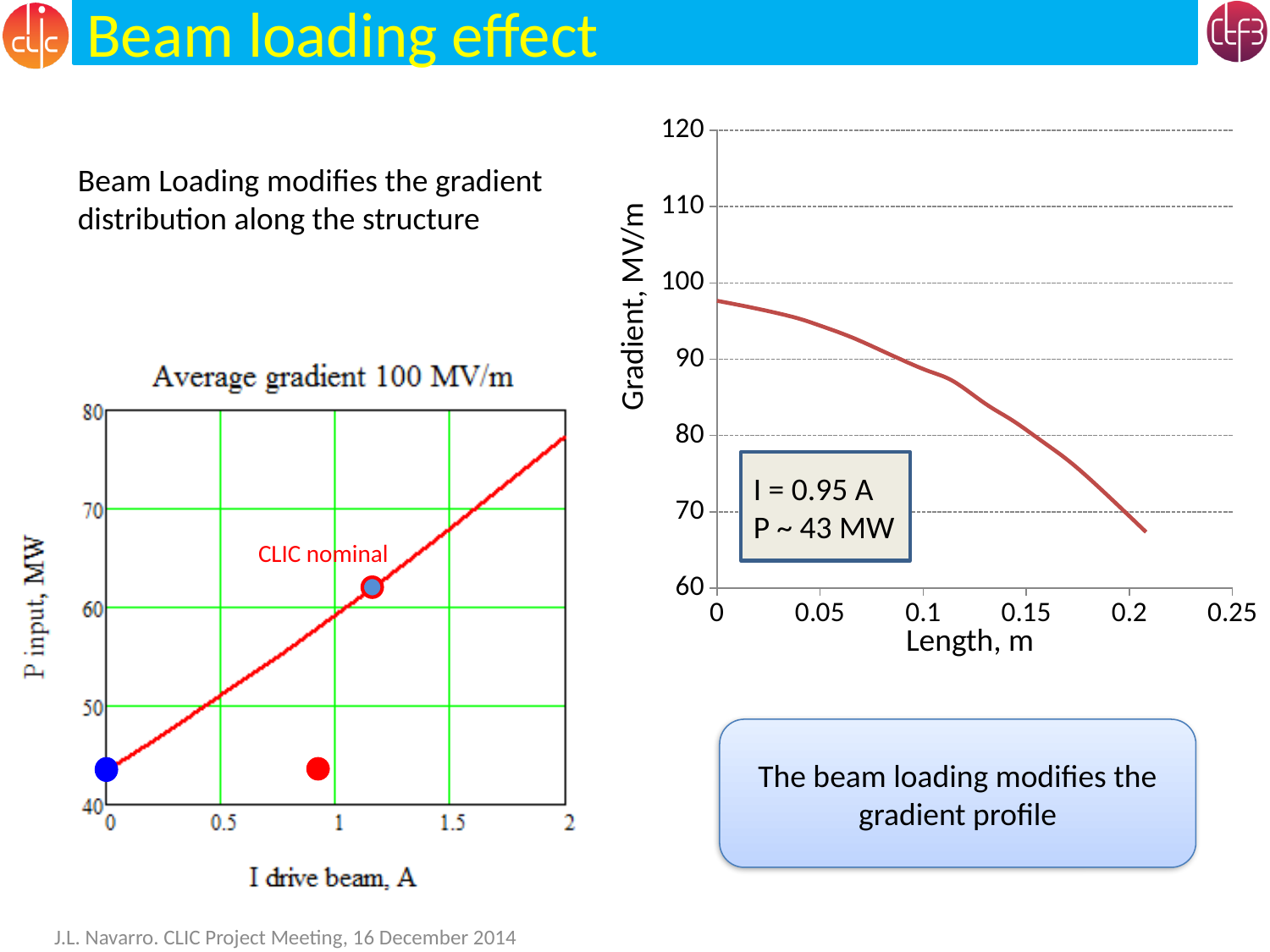
In the right chart (Gradient vs Length), does the gradient rise or fall as length increases? fall In the left chart 'Average gradient 100 MV/m', is the P input at I drive beam = 0 A greater or less than 50 MW? less In the left chart 'Average gradient 100 MV/m', is the P input at I drive beam = 2 A greater or less than 70 MW? greater In the right chart (Gradient vs Length), what drive beam current is stated in the text box on the plot? I = 0.95 A In the right chart (Gradient vs Length), is the gradient at length 0 m greater or less than 100? less What type of chart is the chart on the right titled with the y axis 'Gradient, MV/m'? line chart In the left chart 'Average gradient 100 MV/m', does P input rise or fall as I drive beam increases? rise In the right chart (Gradient vs Length), what is the label of the x axis? Length, m What type of chart is the left chart titled 'Average gradient 100 MV/m'? line chart In the left chart 'Average gradient 100 MV/m', what is the label of the y axis? P input, MW